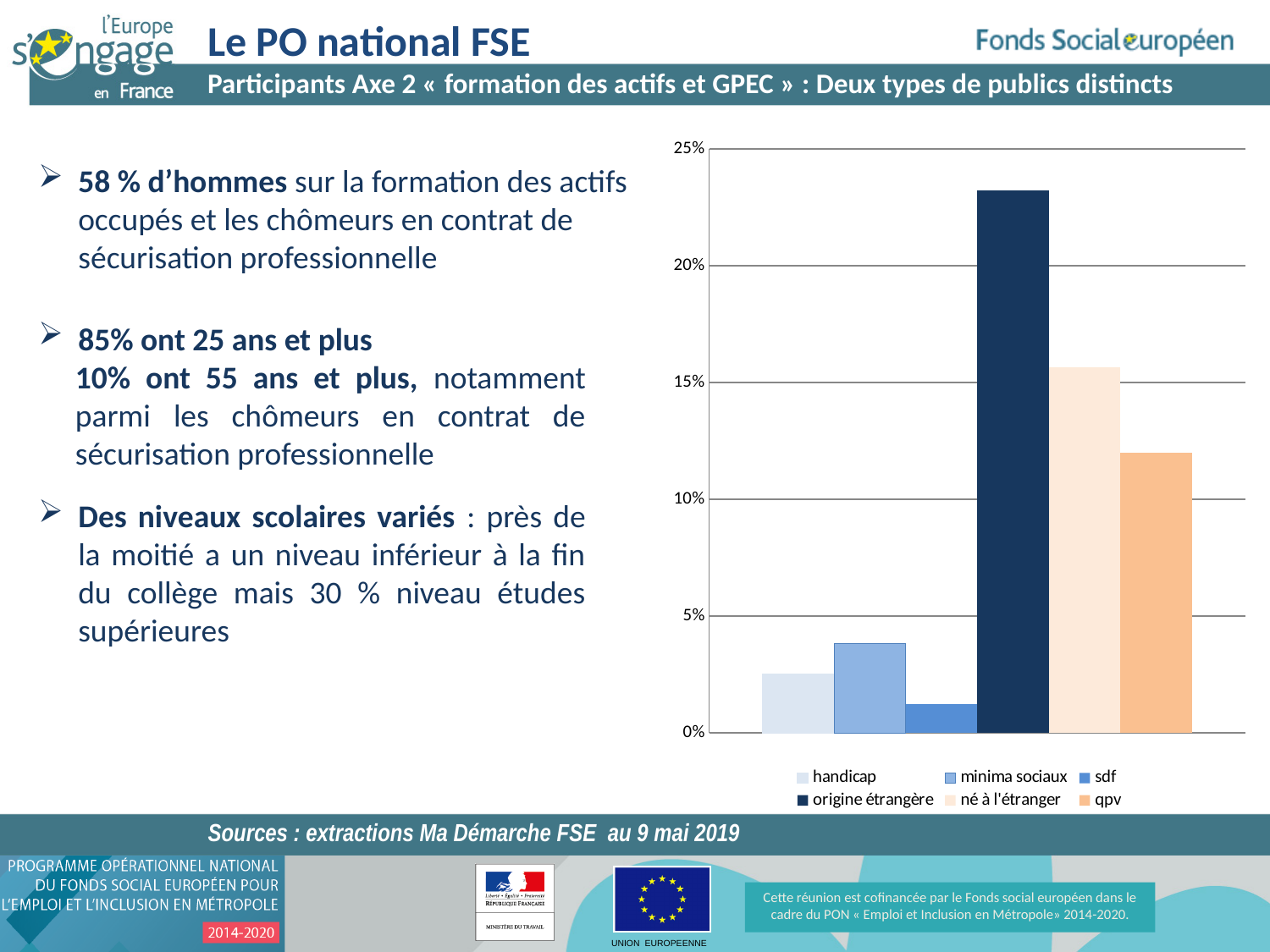
Which is larger, the value for né à l'étranger or the value for qpv? né à l'étranger Is the value for qpv greater or less than 15%? less Which series has the highest value in the chart? origine étrangère What is the highest value shown on the chart's vertical axis? 25% Is the value for né à l'étranger greater or less than 15%? greater Which is larger, the value for minima sociaux or the value for handicap? minima sociaux Is the value for minima sociaux greater or less than 5%? less What kind of chart is shown on the slide? bar chart Which series has the lowest value in the chart? sdf How many series does the chart legend list? 6 How many bars are plotted in the chart? 6